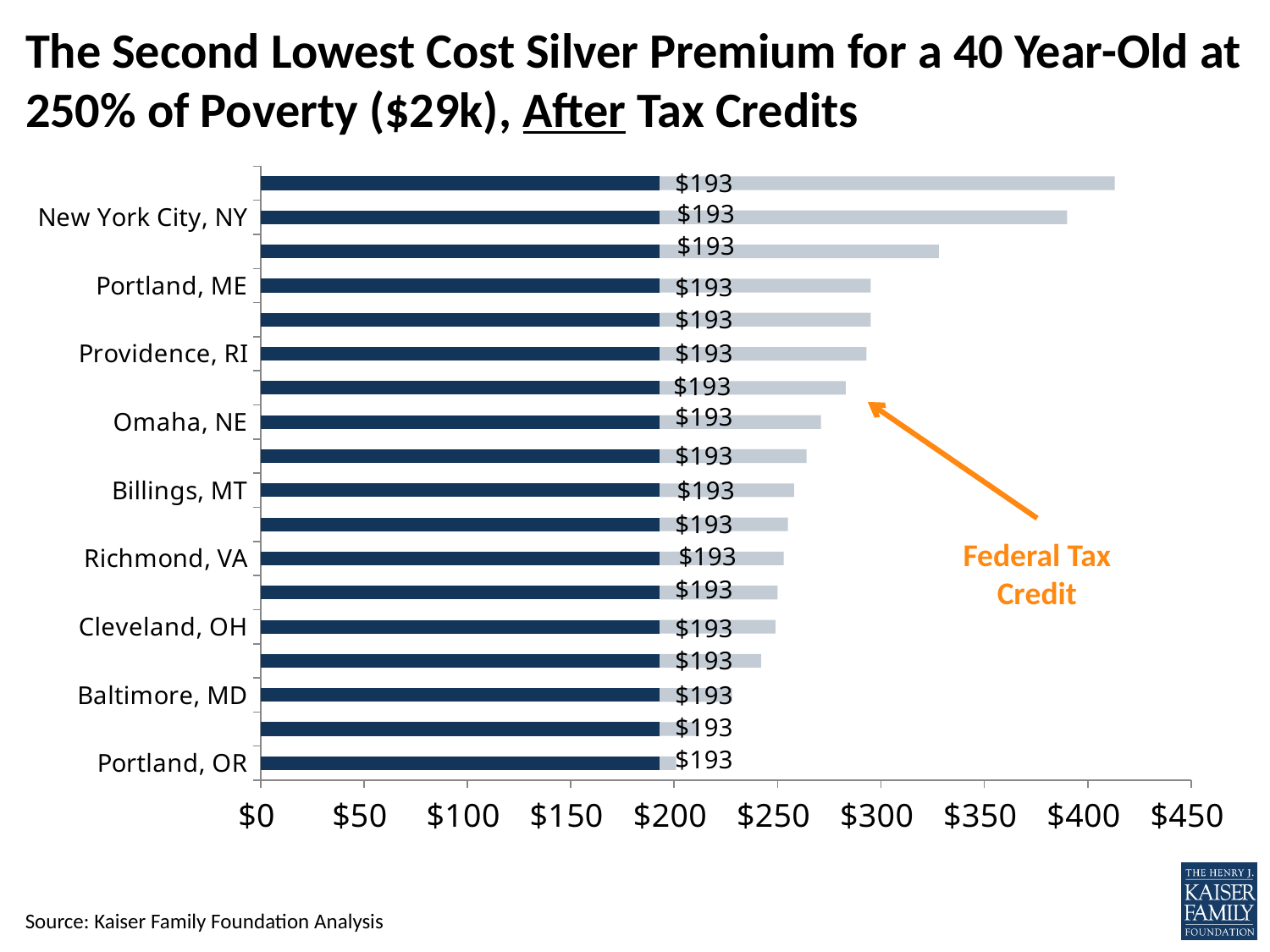
Is the full bar (including the federal tax credit) for Portland, ME greater or less than $250? greater What is the premium after tax credits for Baltimore, MD? $193 What is the premium after tax credits for New York City, NY? $193 What is the highest value shown on the x axis? $450 What is the premium after tax credits for Portland, OR? $193 What kind of chart is shown on the slide? Bar chart How many bars are plotted in the chart? 18 Is the full bar for Portland, OR greater or less than $250? less Which city has the longer full bar, New York City, NY or Omaha, NE? New York City, NY Is the full bar (including the federal tax credit) for New York City, NY greater or less than $350? greater What does the orange annotation say the light gray portion of the bars represents? Federal Tax Credit